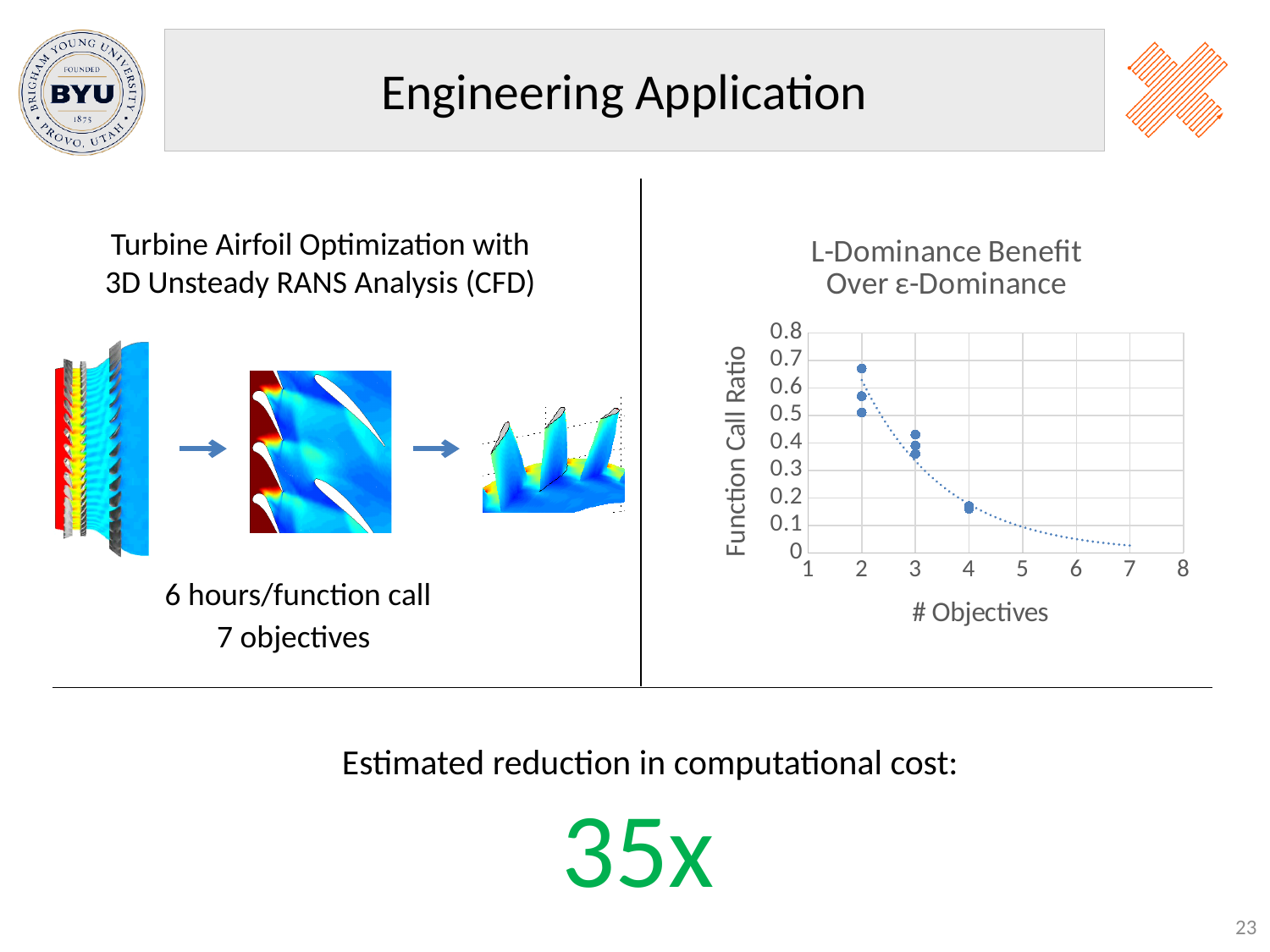
How many distinct # Objectives values have plotted points in the scatter chart? 3 In the scatter chart, are the Function Call Ratio values at 4 objectives greater or less than 0.2? less In the scatter chart, which number of objectives has the highest Function Call Ratio values: 2, 3 or 4? 2 In the scatter chart, is the highest Function Call Ratio value at 2 objectives greater or less than 0.6? greater In the scatter chart, which number of objectives has the lowest Function Call Ratio values: 2, 3 or 4? 4 What kind of chart is shown under the title "L-Dominance Benefit Over ε-Dominance"? scatter chart In the scatter chart, do the Function Call Ratio values rise or fall as the number of objectives increases? fall In the scatter chart, are the Function Call Ratio values larger at 2 objectives or at 4 objectives? 2 objectives What is the label of the y axis of the scatter chart? Function Call Ratio What is the title of the chart on the right side of the slide? L-Dominance Benefit Over ε-Dominance In the scatter chart, are the Function Call Ratio values at 3 objectives greater or less than 0.5? less